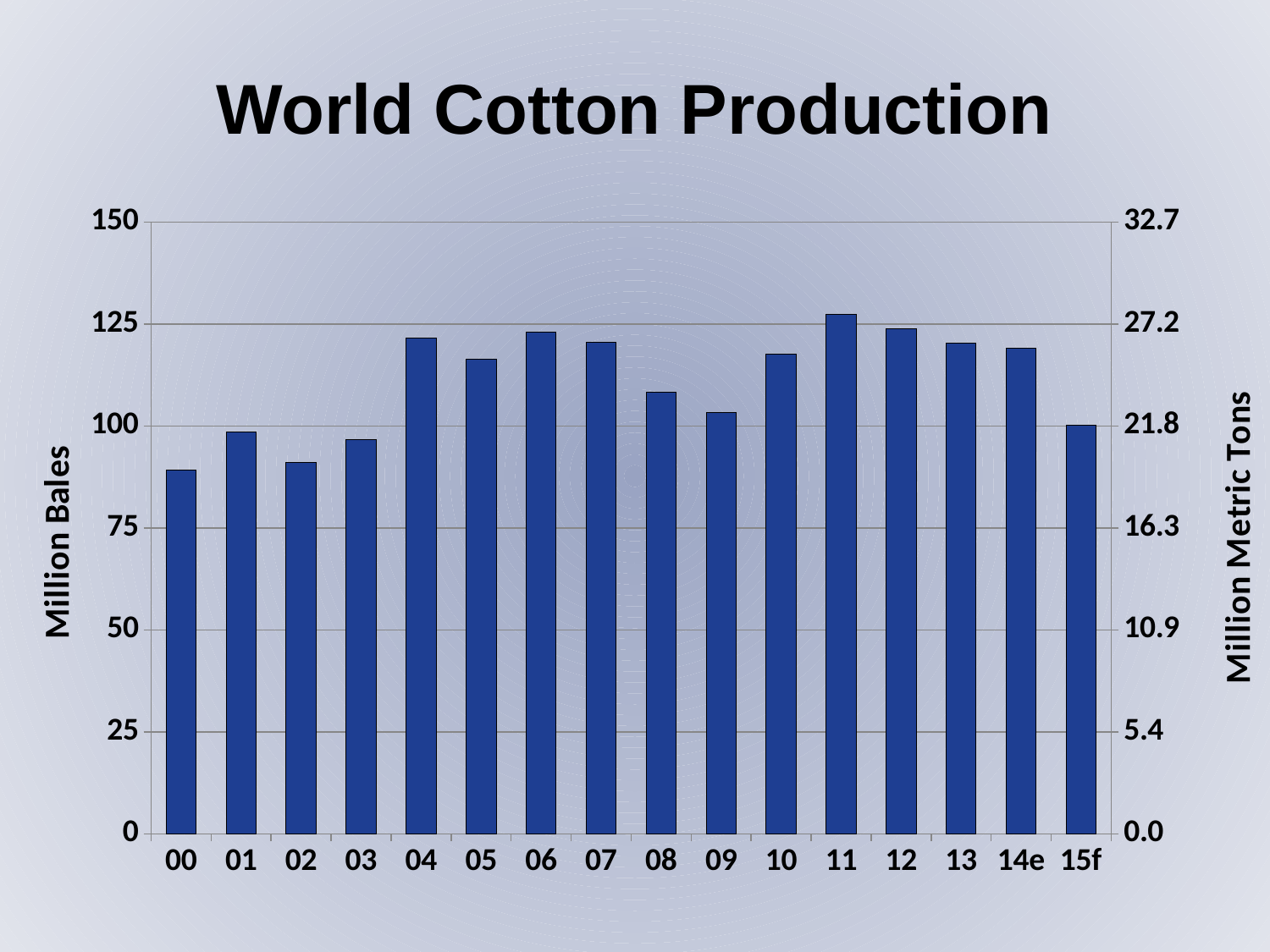
Which is larger, the value for 11 or the value for 09? 11 How many years (bars) are plotted on the chart? 16 Which is larger, the value for 04 or the value for 00? 04 Do the values rise or fall from 11 to 15f? fall Which year has the highest world cotton production? 11 What kind of chart is shown on the slide? bar chart What is the label of the left vertical axis? Million Bales Is the value for 04 greater or less than 100 million bales? greater What is the title of the chart? World Cotton Production Is the value for 11 greater or less than 125 million bales? greater Is the value for 00 greater or less than 100 million bales? less